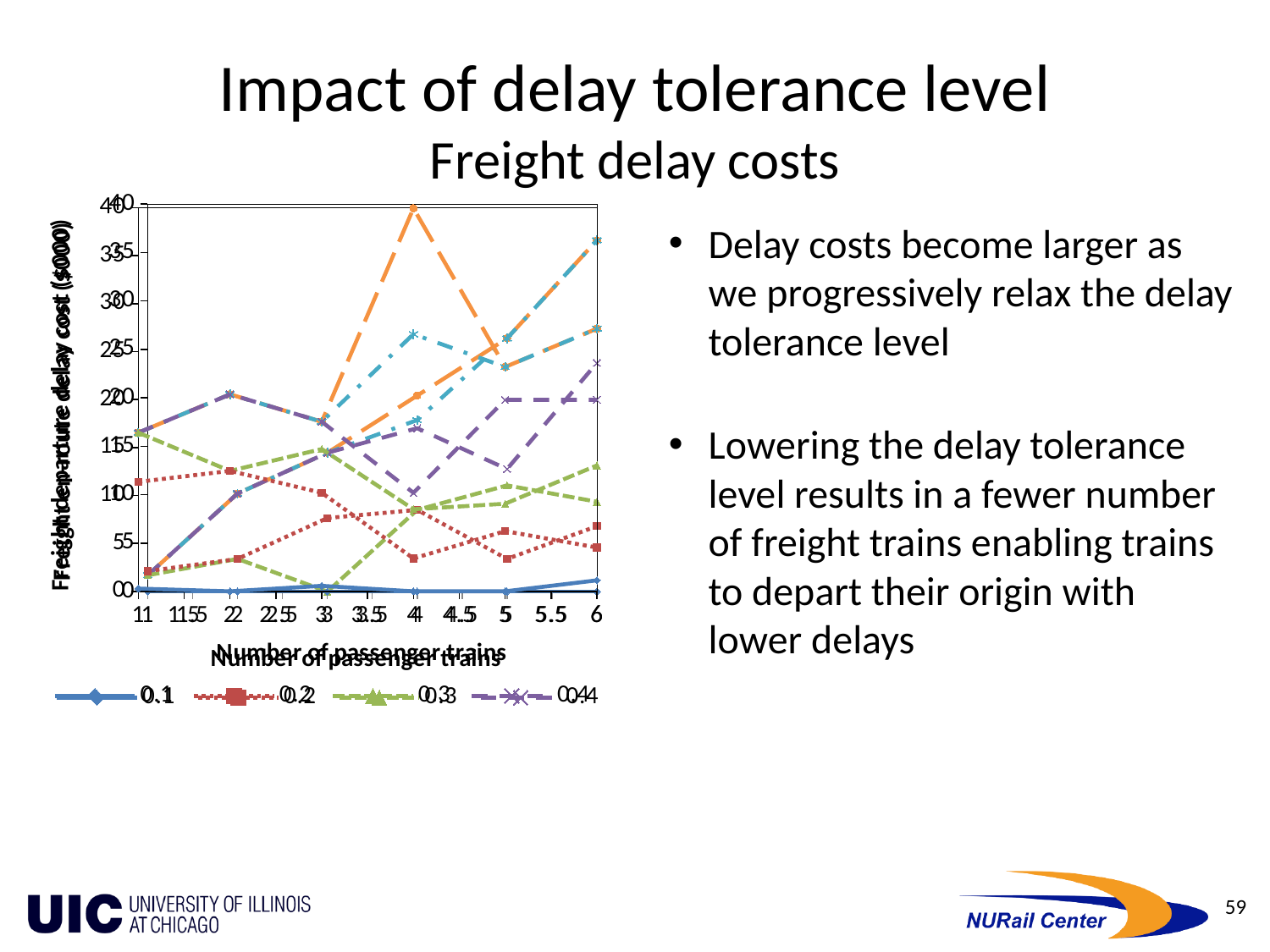
What is the label of the chart's x axis? Number of passenger trains At 1 passenger train, which series has the larger value, 0.1 or 0.4? 0.4 What are the series names listed in the chart's legend? 0.1, 0.2, 0.3, 0.4 What kind of chart is shown on the slide? line chart How many series does the chart's legend list? 4 How many data points does each series have along the x axis (at the integer values 1 to 6)? 6 Is the value of the 0.1 series at 6 passenger trains greater or less than 5? less